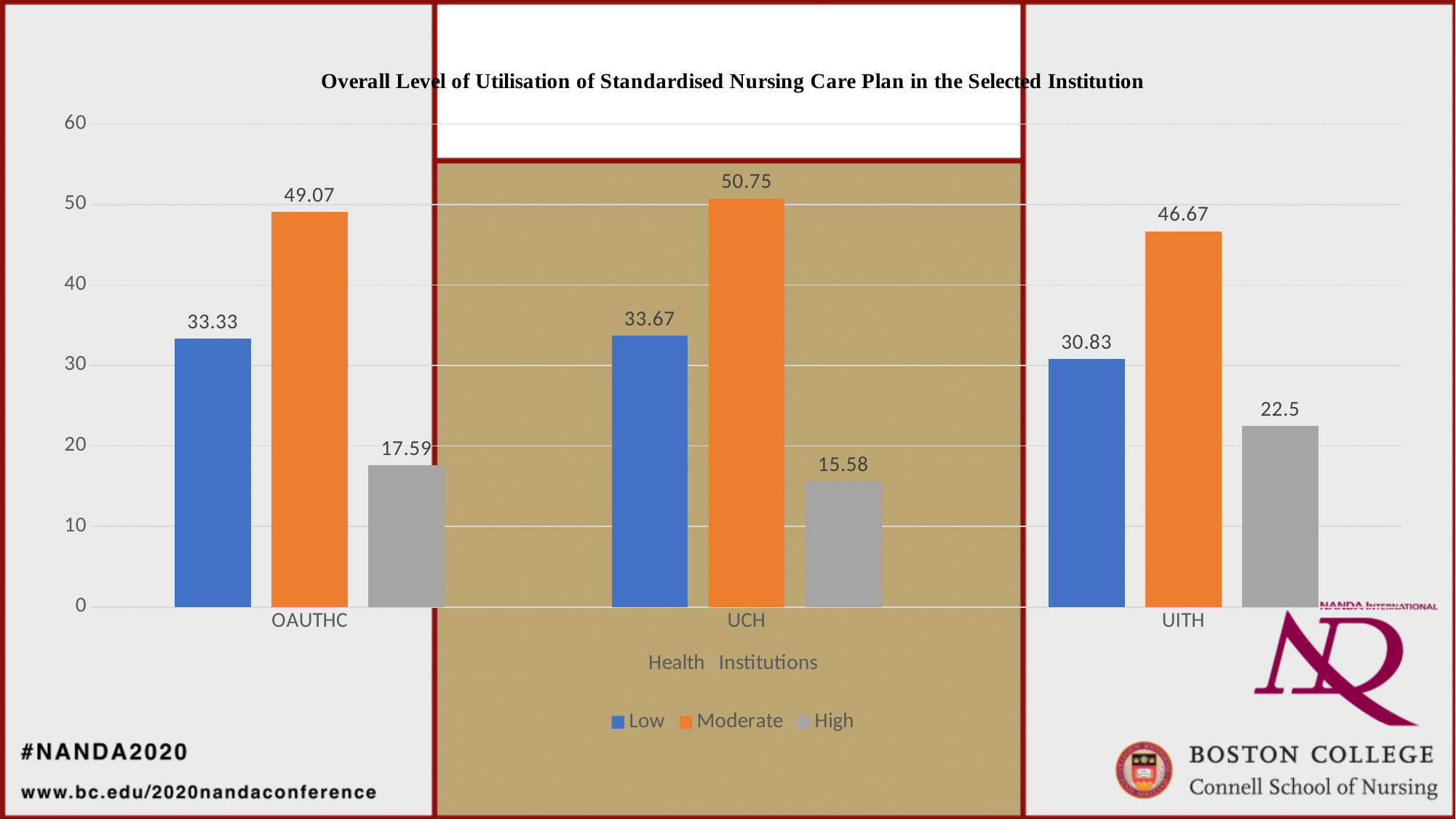
Is the High value for OAUTHC larger than the High value for UITH? No What kind of chart is shown on the slide? Bar chart Is the Low value for UCH greater or less than 30? greater Which institution has the lowest High value? UCH Which institution has the highest Moderate value? UCH What is the Low value for OAUTHC? 33.33 What is the Moderate value for UCH? 50.75 How many health institutions are shown on the x axis? 3 What is the High value for UITH? 22.5 What is the difference between the Moderate and Low values for UITH? 15.84 What is the title of the chart? Overall Level of Utilisation of Standardised Nursing Care Plan in the Selected Institution How many series does the legend list? 3